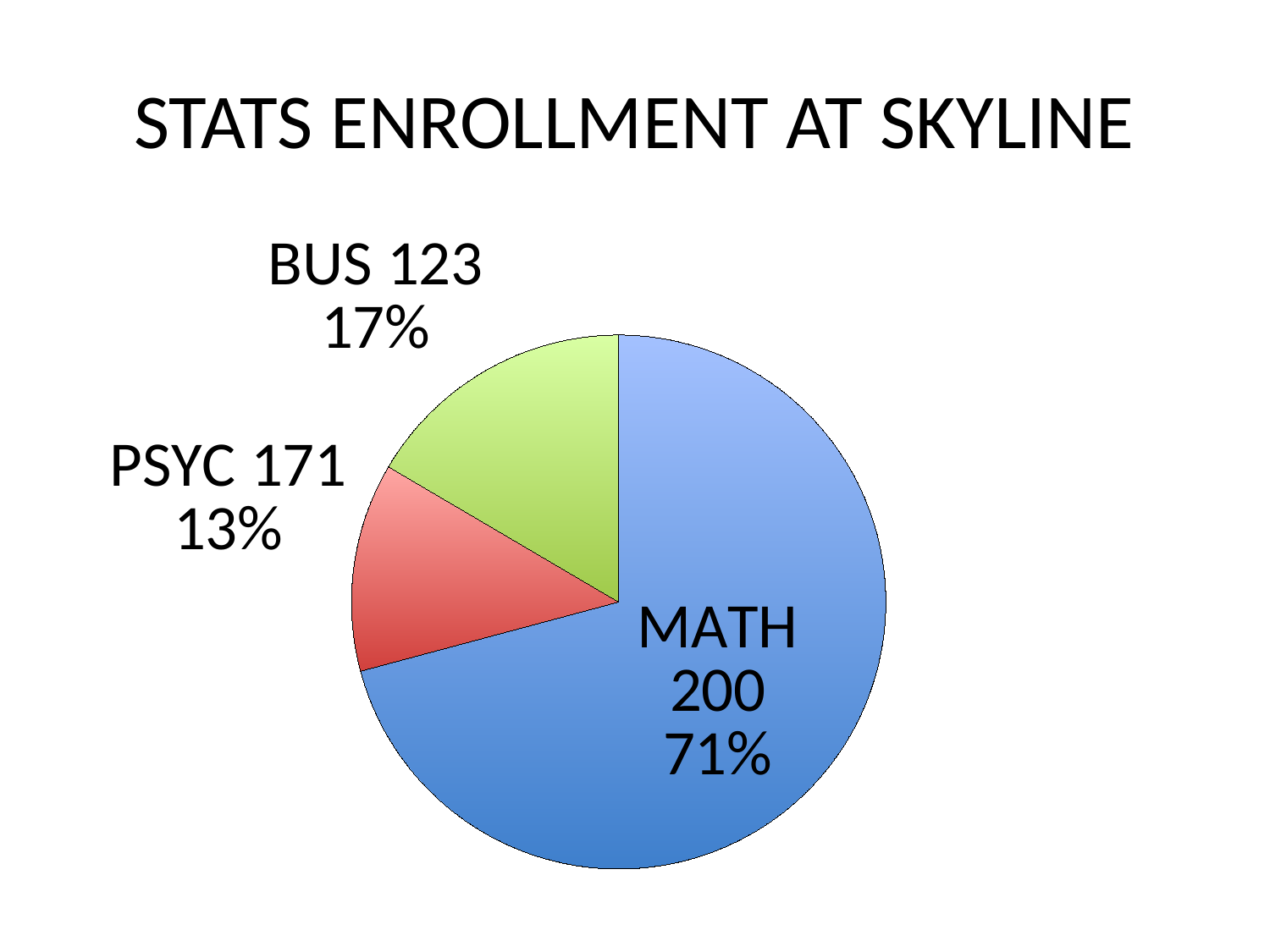
What is the title of the chart? STATS ENROLLMENT AT SKYLINE What is the difference in percentage points between the BUS 123 share and the PSYC 171 share? 4 Which course has the largest slice of the pie? MATH 200 What is the difference in percentage points between the MATH 200 share and the BUS 123 share? 54 What share of the pie does MATH 200 represent? 71% What kind of chart is shown on the slide? pie chart How many slices does the pie chart have? 3 Which course has the smallest slice of the pie? PSYC 171 Which slice is larger, BUS 123 or PSYC 171? BUS 123 What colour is the MATH 200 slice? blue What share of the pie does BUS 123 represent? 17% What share of the pie does PSYC 171 represent? 13%